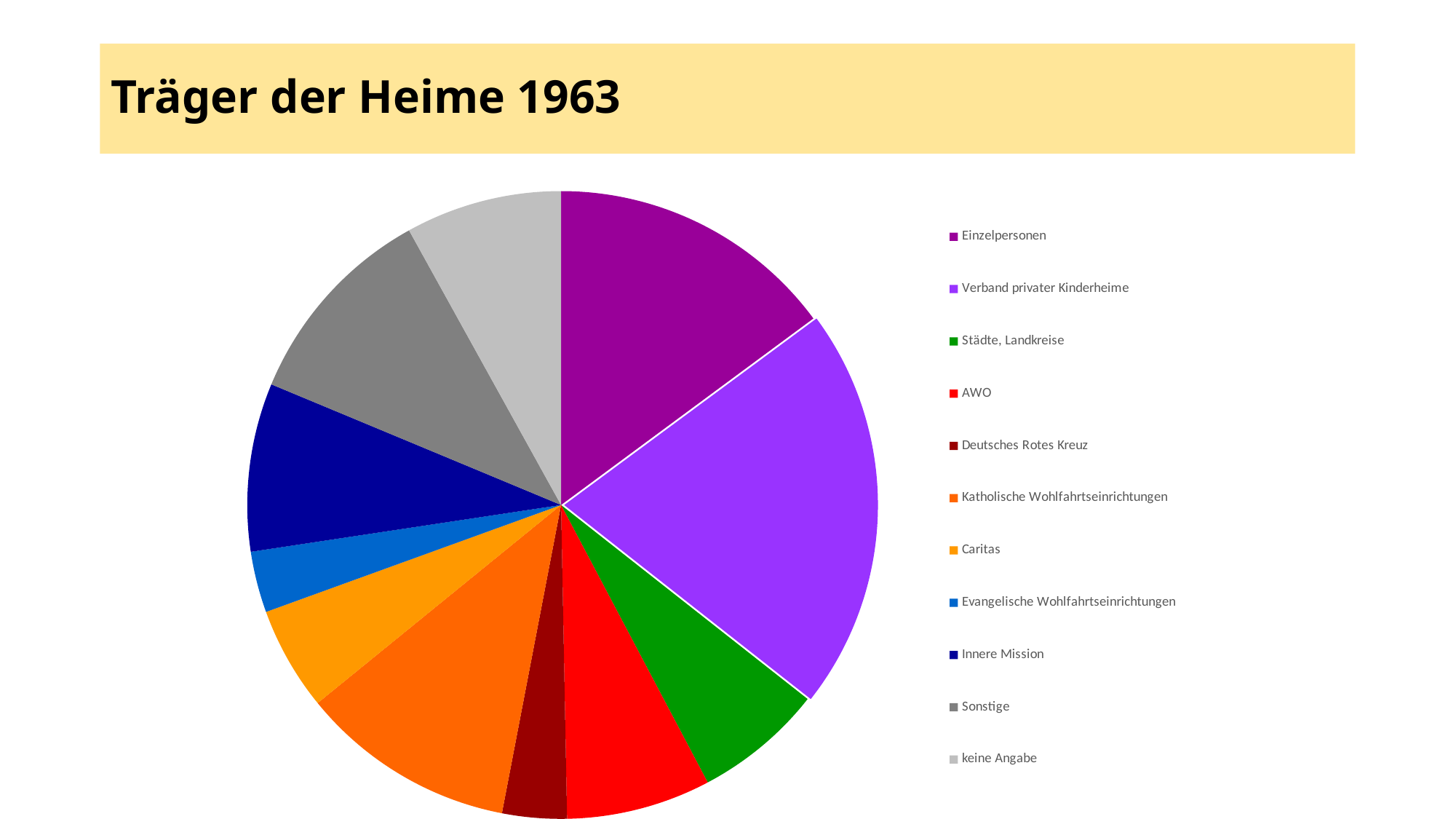
What is the title of the chart on the slide? Träger der Heime 1963 Which slice is larger, Verband privater Kinderheime or Einzelpersonen? Verband privater Kinderheime Which category is shown in light grey in the pie chart? keine Angabe Which slice is larger, Verband privater Kinderheime or Katholische Wohlfahrtseinrichtungen? Verband privater Kinderheime What kind of chart is shown on the slide? pie chart How many categories does the pie chart's legend list? 11 Which slice is larger, Innere Mission or Evangelische Wohlfahrtseinrichtungen? Innere Mission Which category has the largest slice of the pie chart? Verband privater Kinderheime